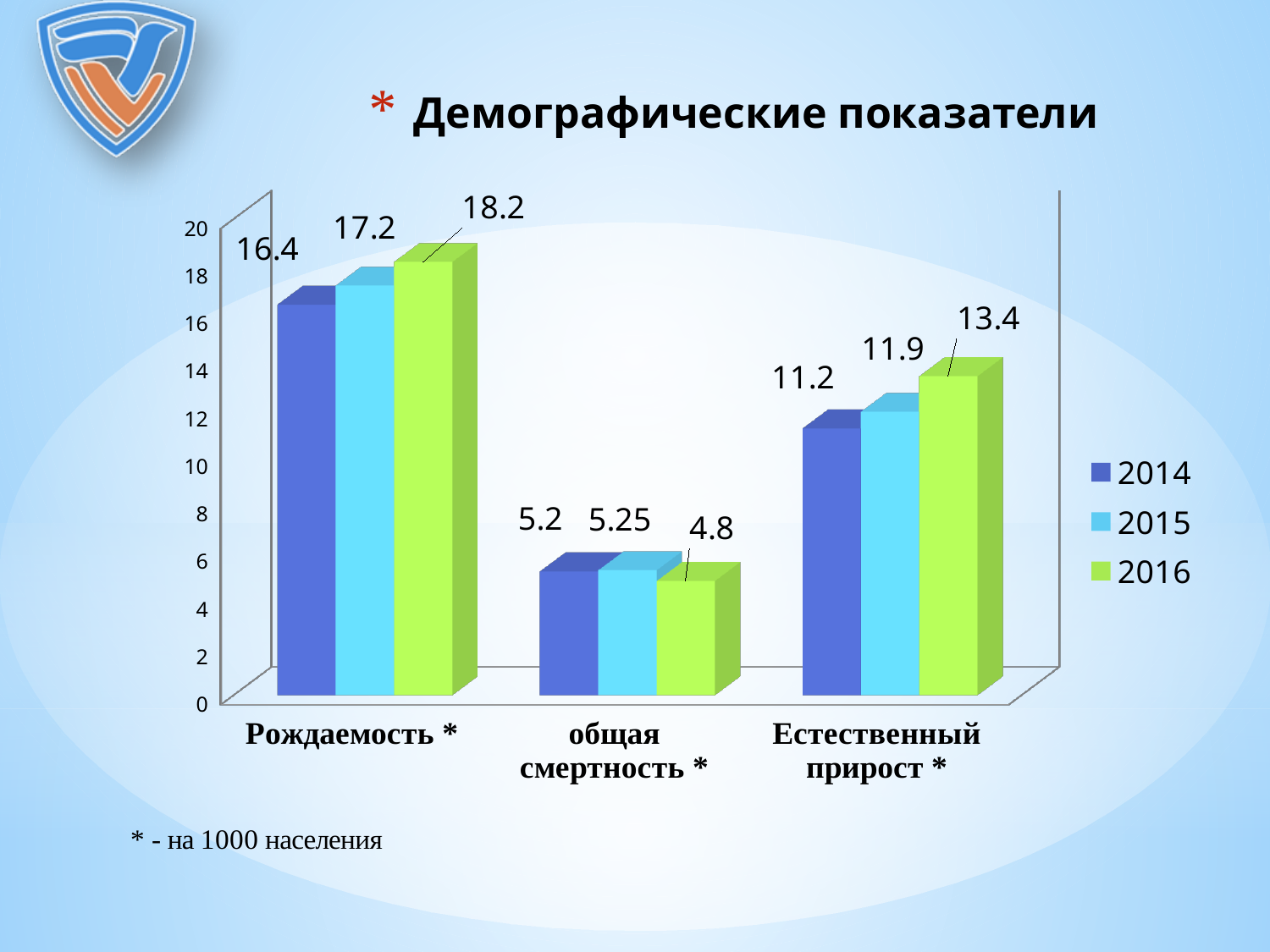
What kind of chart is shown on the slide? bar chart What is the difference between the 2016 and 2014 values for Рождаемость? 1.8 Which is larger for общая смертность: the 2014 value or the 2016 value? 2014 How many categories are shown on the x axis? 3 Do the values for Естественный прирост rise or fall from 2014 to 2016? rise What is the value for Рождаемость in 2016? 18.2 How many series does the legend list? 3 What is the value for Естественный прирост in 2014? 11.2 What is the difference between the 2016 and 2015 values for Естественный прирост? 1.5 Which category has the highest value in 2016? Рождаемость What is the value for общая смертность in 2015? 5.25 Which category has the lowest value in 2014? общая смертность